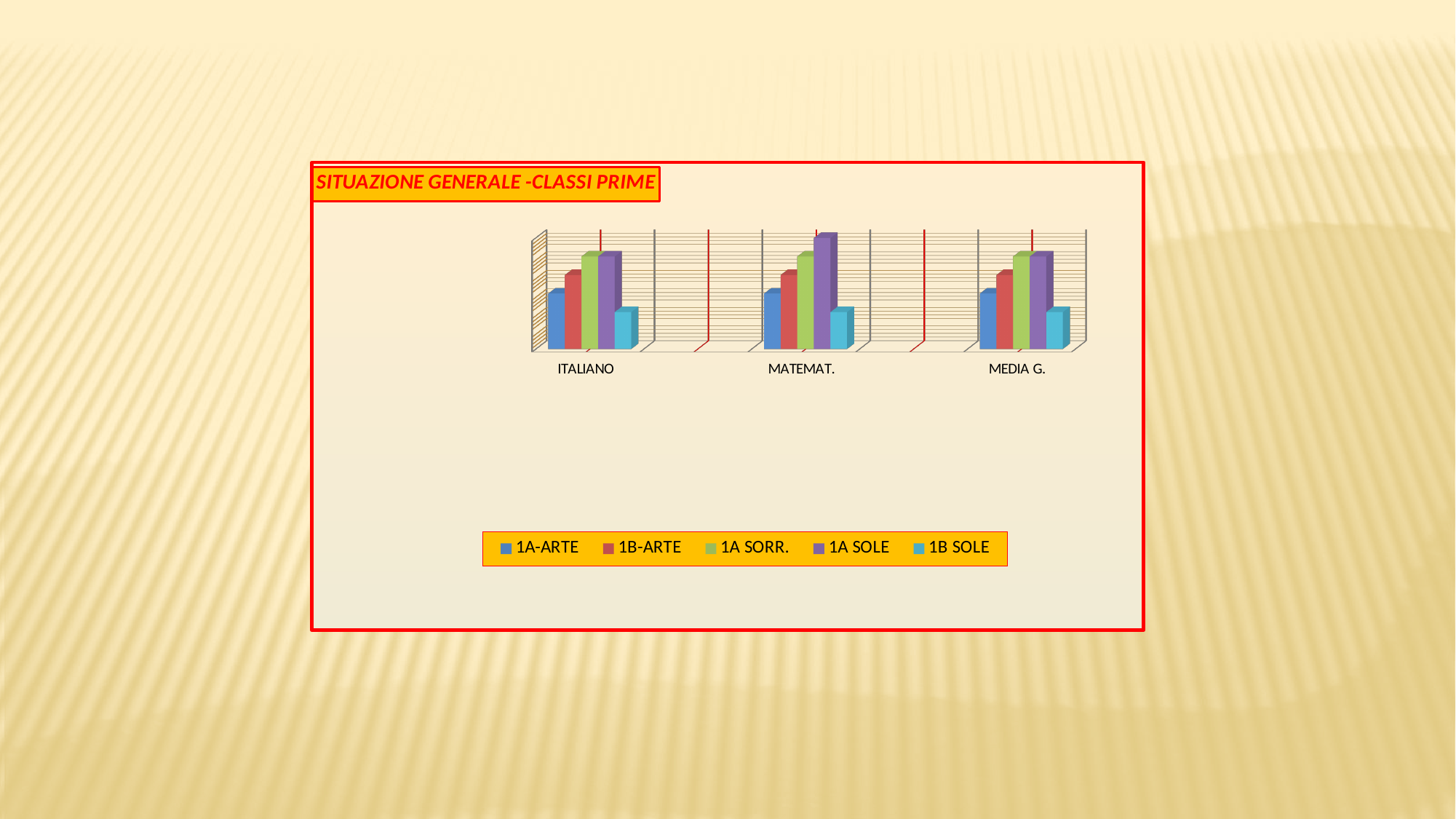
Which series has the lowest value for ITALIANO? 1B SOLE What kind of chart is shown on the slide? bar chart Which series has the highest value for MATEMAT.? 1A SOLE For ITALIANO, which is larger: the value for 1A-ARTE or the value for 1B-ARTE? 1B-ARTE Which series has the lowest value for MEDIA G.? 1B SOLE Which series has the lowest value for MATEMAT.? 1B SOLE How many categories are shown on the x axis of the chart? 3 How many series does the legend list? 5 For MATEMAT., which is larger: the value for 1A SORR. or the value for 1A SOLE? 1A SOLE Which series is shown in purple in the legend? 1A SOLE For MEDIA G., which is larger: the value for 1A-ARTE or the value for 1B SOLE? 1A-ARTE What is the title of the chart? SITUAZIONE GENERALE -CLASSI PRIME